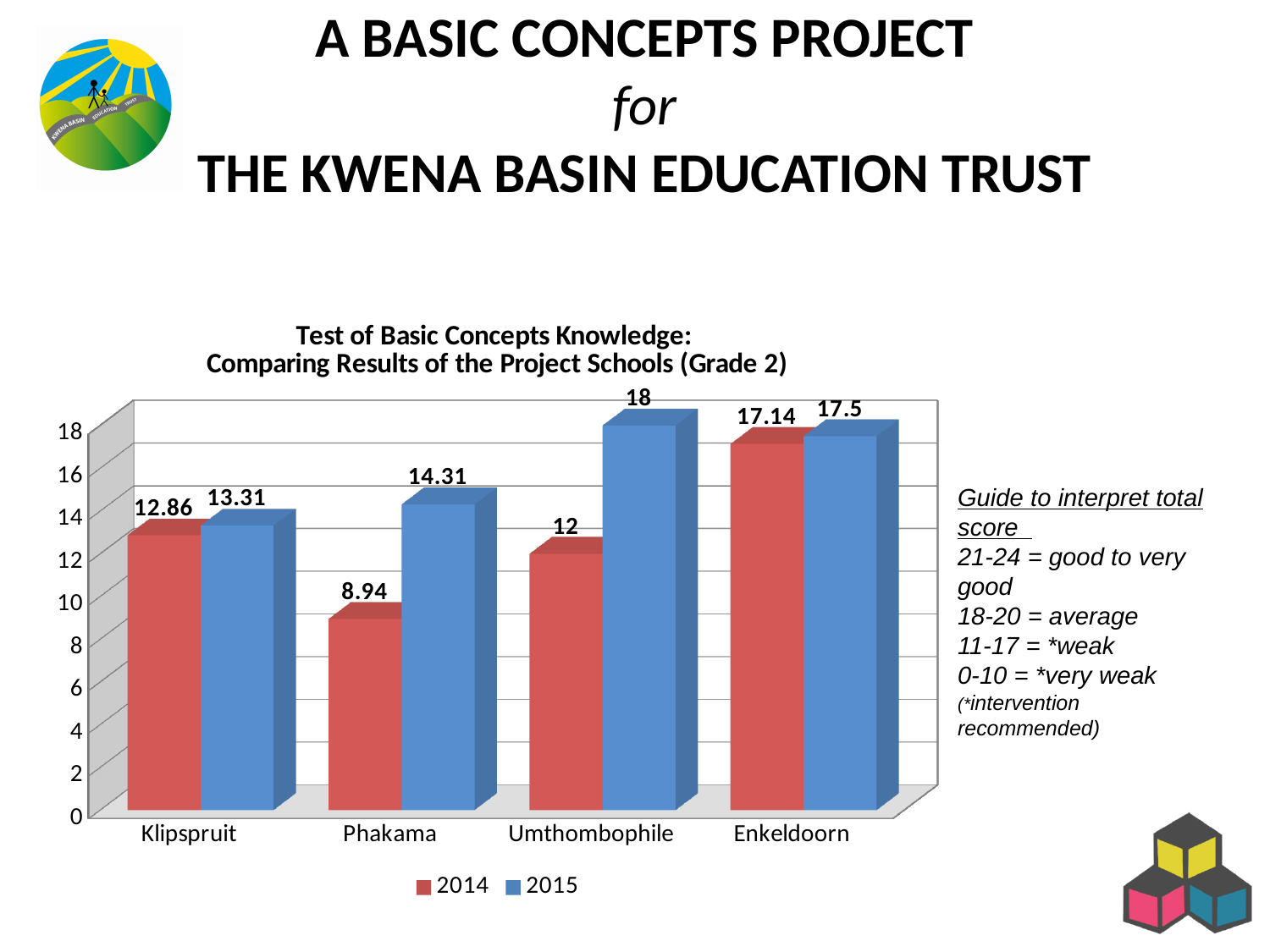
How many schools are shown on the x axis? 4 What was the 2014 score for Phakama? 8.94 Which school had the lowest 2014 score? Phakama What kind of chart is shown? Bar chart Which school had the highest 2015 score? Umthombophile Which is larger for Klipspruit, the 2014 score or the 2015 score? 2015 What is the difference between the 2015 scores of Umthombophile and Enkeldoorn? 0.5 Which colour represents the 2014 series? Red How many series does the legend list? 2 What was the 2014 score for Enkeldoorn? 17.14 What is the difference between the 2015 and 2014 scores for Phakama? 5.37 What was the 2015 score for Umthombophile? 18